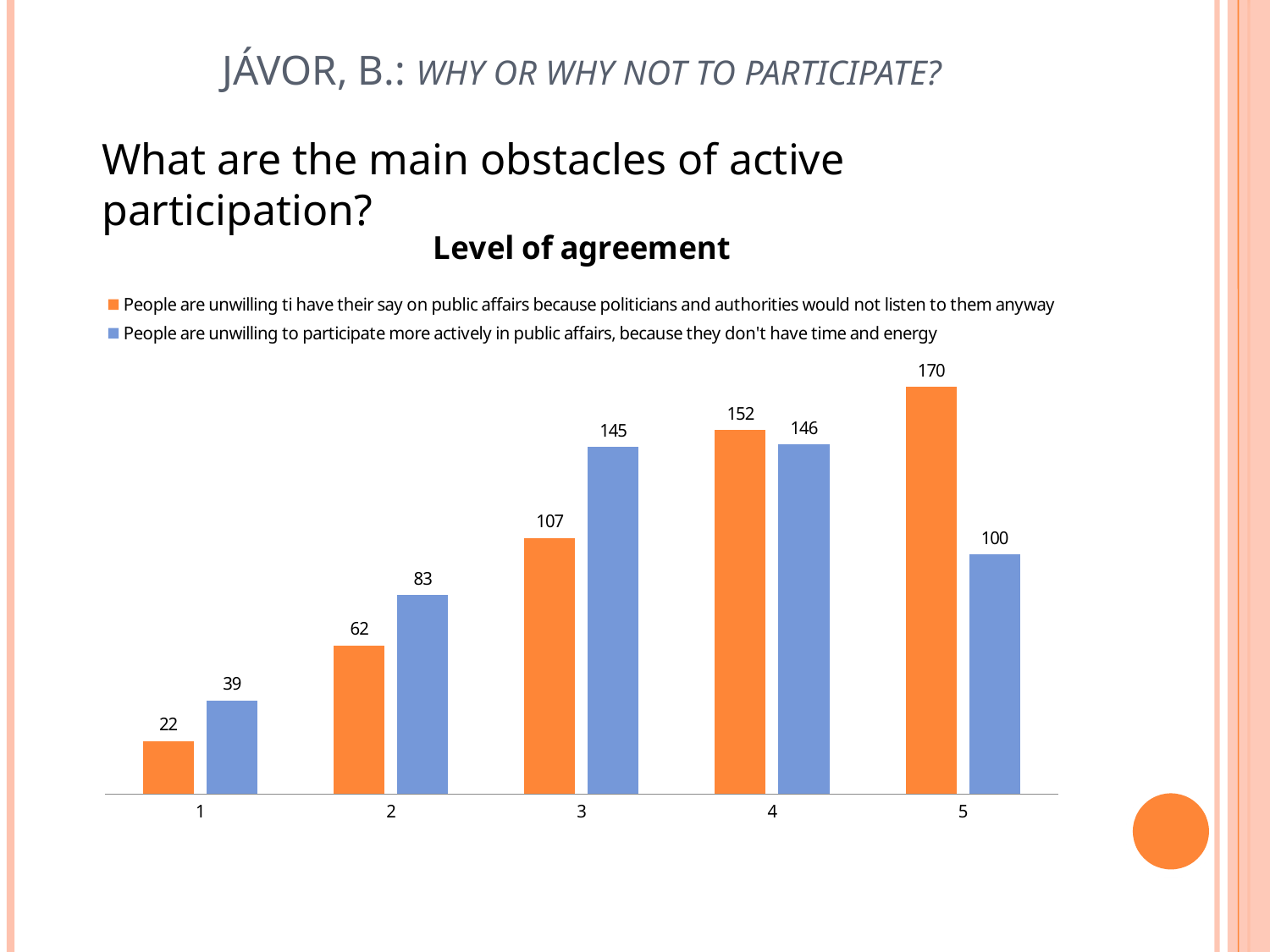
At which level of agreement is the orange series (politicians would not listen) lowest? 1 What is the value of the orange series (politicians would not listen) at level 1? 22 How many levels of agreement are shown on the x axis? 5 What is the value of the blue series (don't have time and energy) at level 3? 145 What kind of chart is shown on the slide? bar chart How many series does the legend list? 2 At level 2, which series has the larger value, orange or blue? blue What is the value of the orange series (politicians would not listen) at level 5? 170 What is the title of the chart? Level of agreement What is the difference between the orange and blue values at level 5? 70 Does the orange series rise or fall as the level of agreement increases from 1 to 5? rise At which level of agreement is the blue series (don't have time and energy) highest? 4